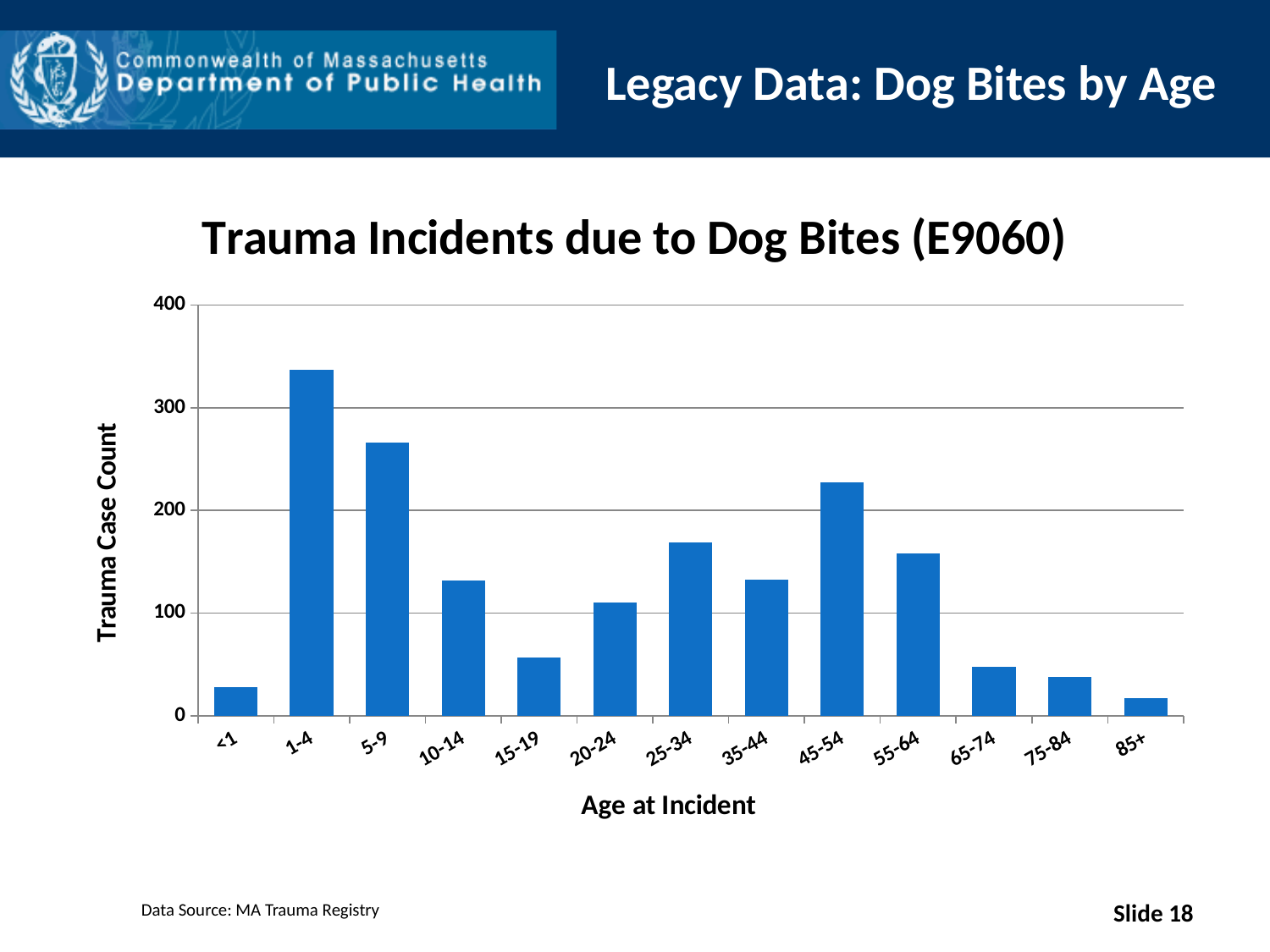
Is the value for the 5-9 age group greater or less than 200? greater Which age group has the lowest trauma case count? 85+ What is the title of the chart? Trauma Incidents due to Dog Bites (E9060) What is the label of the y axis? Trauma Case Count Is the value for the 15-19 age group greater or less than 100? less How many age categories are shown on the x axis? 13 Is the value for the 45-54 age group greater or less than 200? greater Which age group has the highest trauma case count? 1-4 Which age group has a higher trauma case count, 5-9 or 45-54? 5-9 What kind of chart is shown on the slide? bar chart